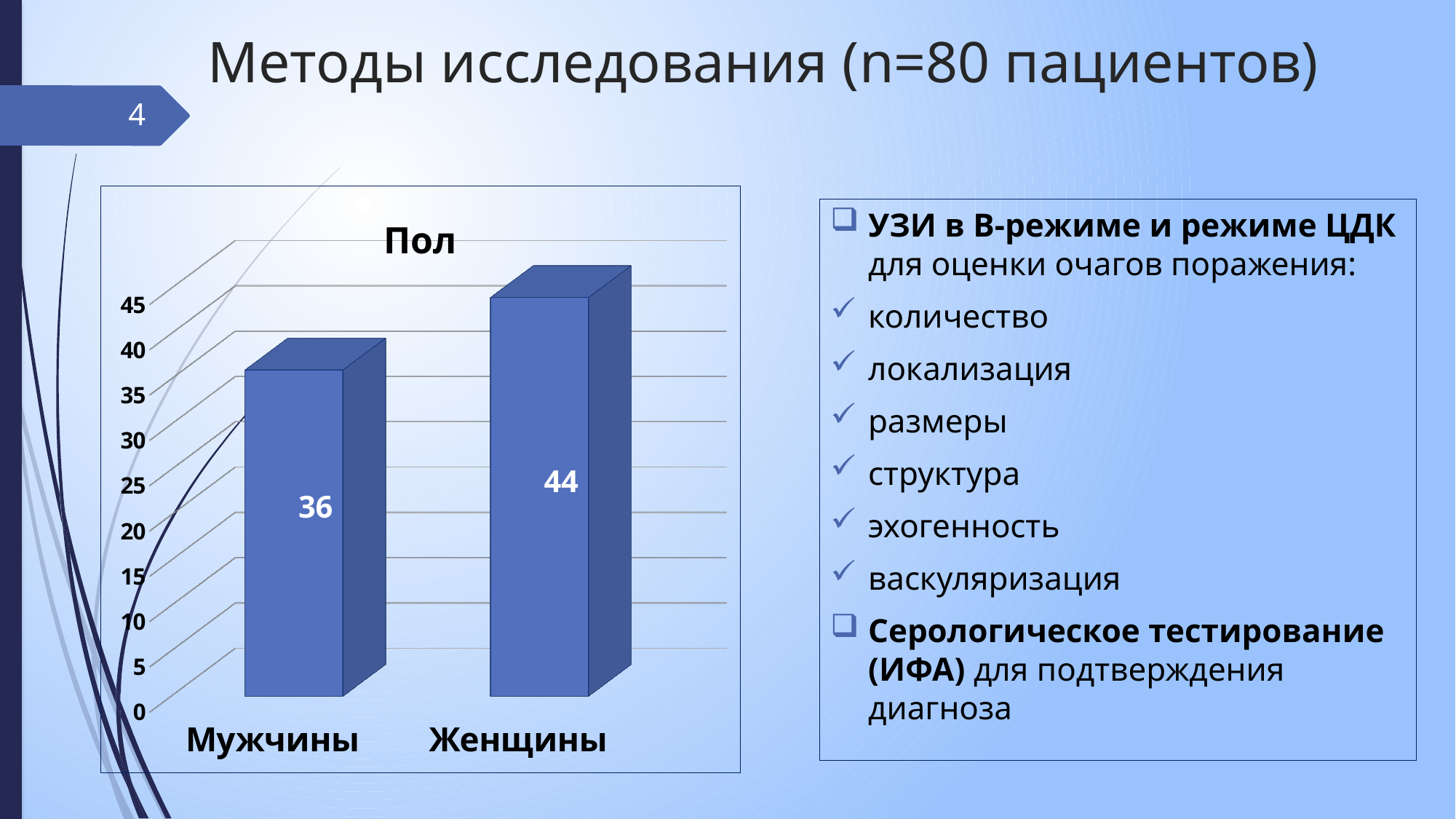
What is the difference between the values for Женщины and Мужчины? 8 Is the value for Мужчины greater or less than 40? less What is the value for Женщины in the chart? 44 How many categories are shown in the chart? 2 Which category has the lowest value in the chart? Мужчины What kind of chart is shown on the slide? bar chart Which category has the highest value in the chart? Женщины What is the total of the two values shown in the chart? 80 What is the value for Мужчины in the chart? 36 What is the title of the chart? Пол Which is larger, the value for Мужчины or the value for Женщины? Женщины Is the value for Женщины greater or less than 40? greater